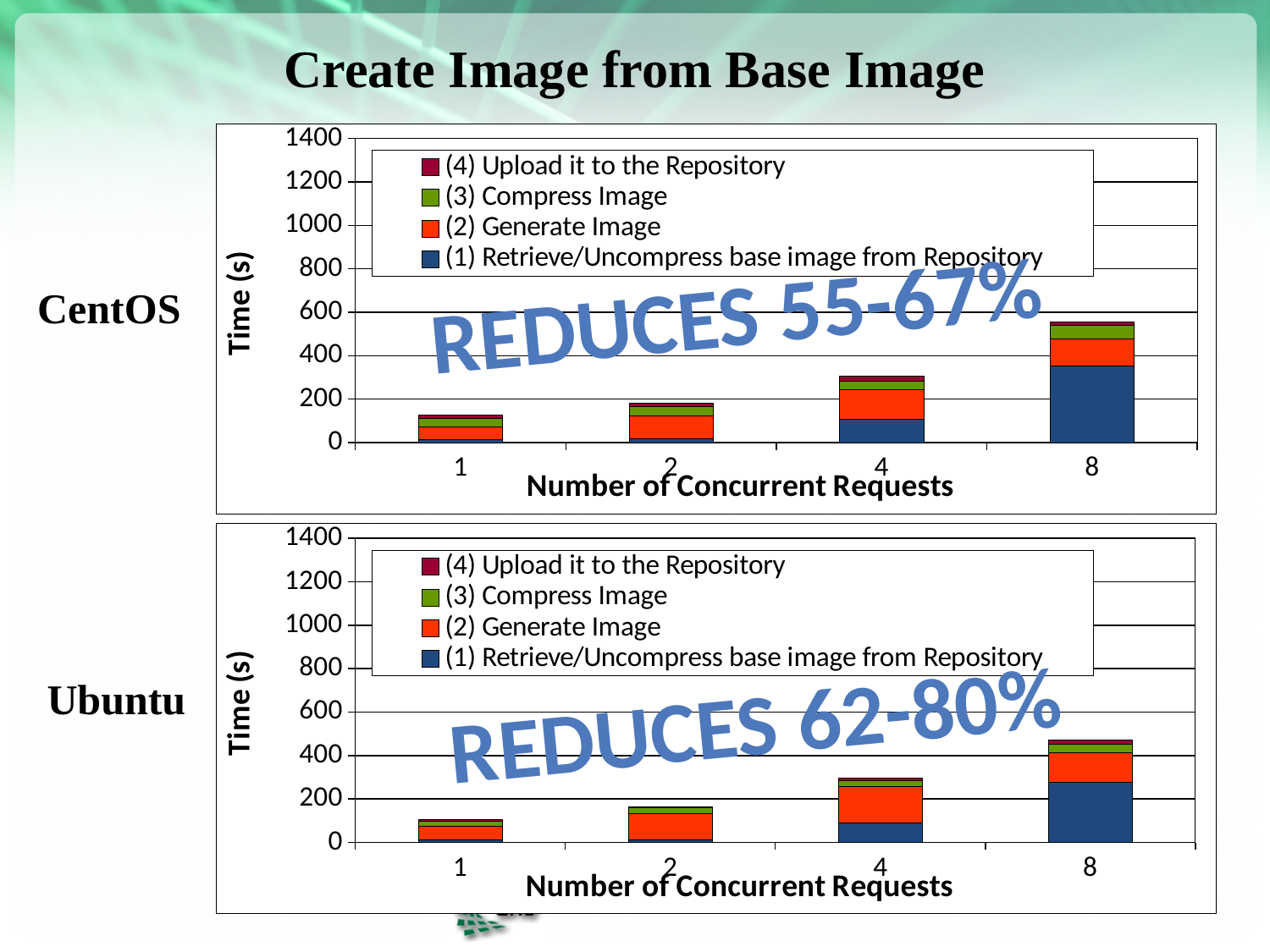
In the CentOS chart, what kind of chart is shown? stacked bar chart In the CentOS chart, how many categories are shown on the x axis? 4 In the CentOS chart, which number of concurrent requests has the tallest stacked bar? 8 In the Ubuntu chart, which number of concurrent requests has the shortest stacked bar? 1 In the CentOS chart, is the total time for 4 concurrent requests greater or less than 200? greater In the Ubuntu chart, is the total time for 8 concurrent requests greater or less than 400? greater In the Ubuntu chart, does the total time rise or fall as the number of concurrent requests increases? rise In the Ubuntu chart, how many series does the legend list? 4 In the CentOS chart, which series is listed first in the legend? (4) Upload it to the Repository What is the y-axis label on the Ubuntu chart? Time (s) In the Ubuntu chart, is the total time for 1 concurrent request greater or less than 200? less